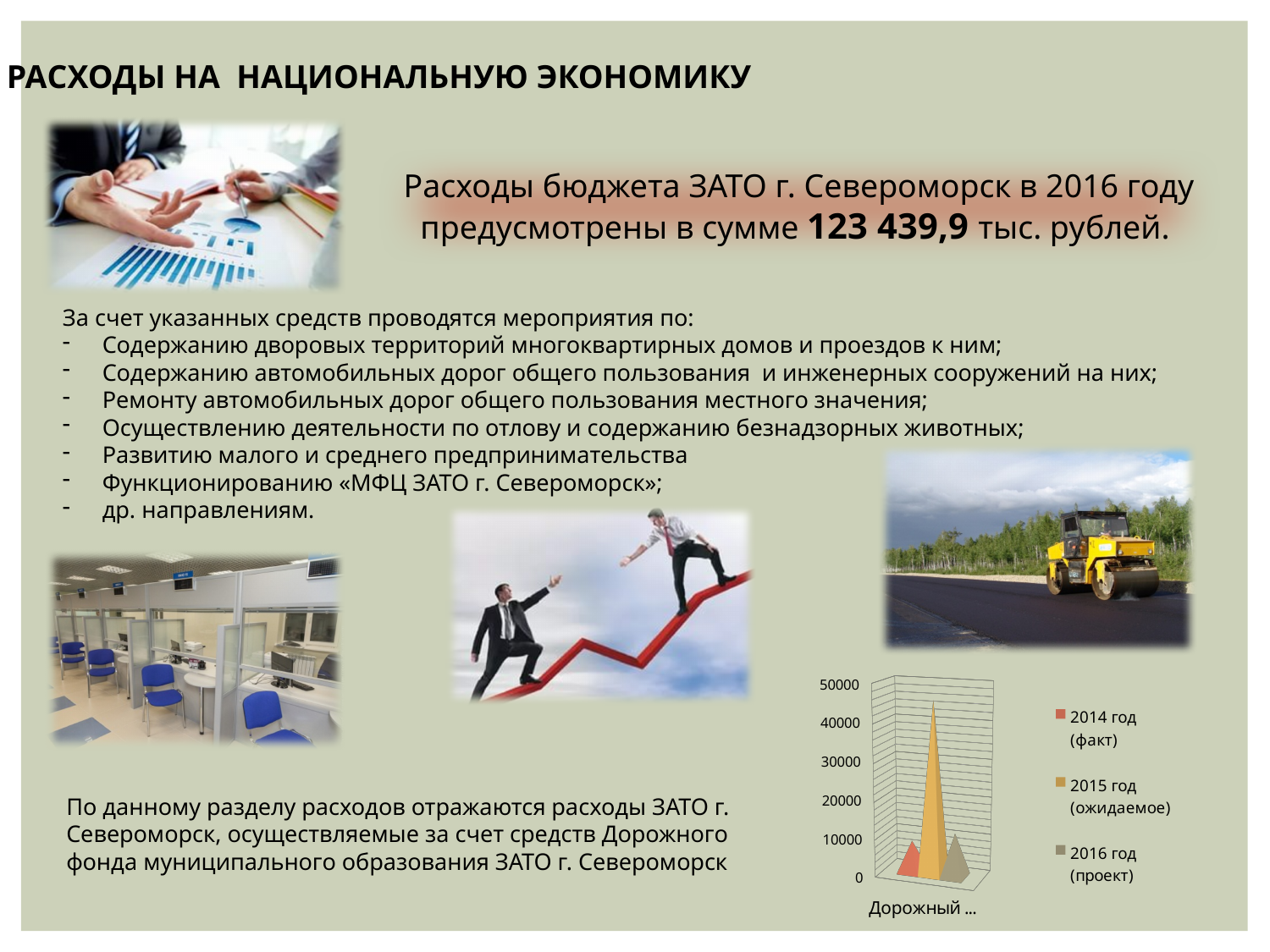
Which series has the highest value in the chart? 2015 год (ожидаемое) Which is larger, the value for 2015 год (ожидаемое) or the value for 2016 год (проект)? 2015 год (ожидаемое) Which is larger, the value for 2015 год (ожидаемое) or the value for 2014 год (факт)? 2015 год (ожидаемое) Is the value for 2015 год (ожидаемое) greater or less than 30000? greater Is the value for 2014 год (факт) greater or less than 20000? less What is the highest value shown on the chart's vertical axis? 50000 Which series in the chart legend is shown in yellow? 2015 год (ожидаемое) Is the value for 2016 год (проект) greater or less than 30000? less How many categories are shown on the x axis of the chart? 1 How many series does the chart legend list? 3